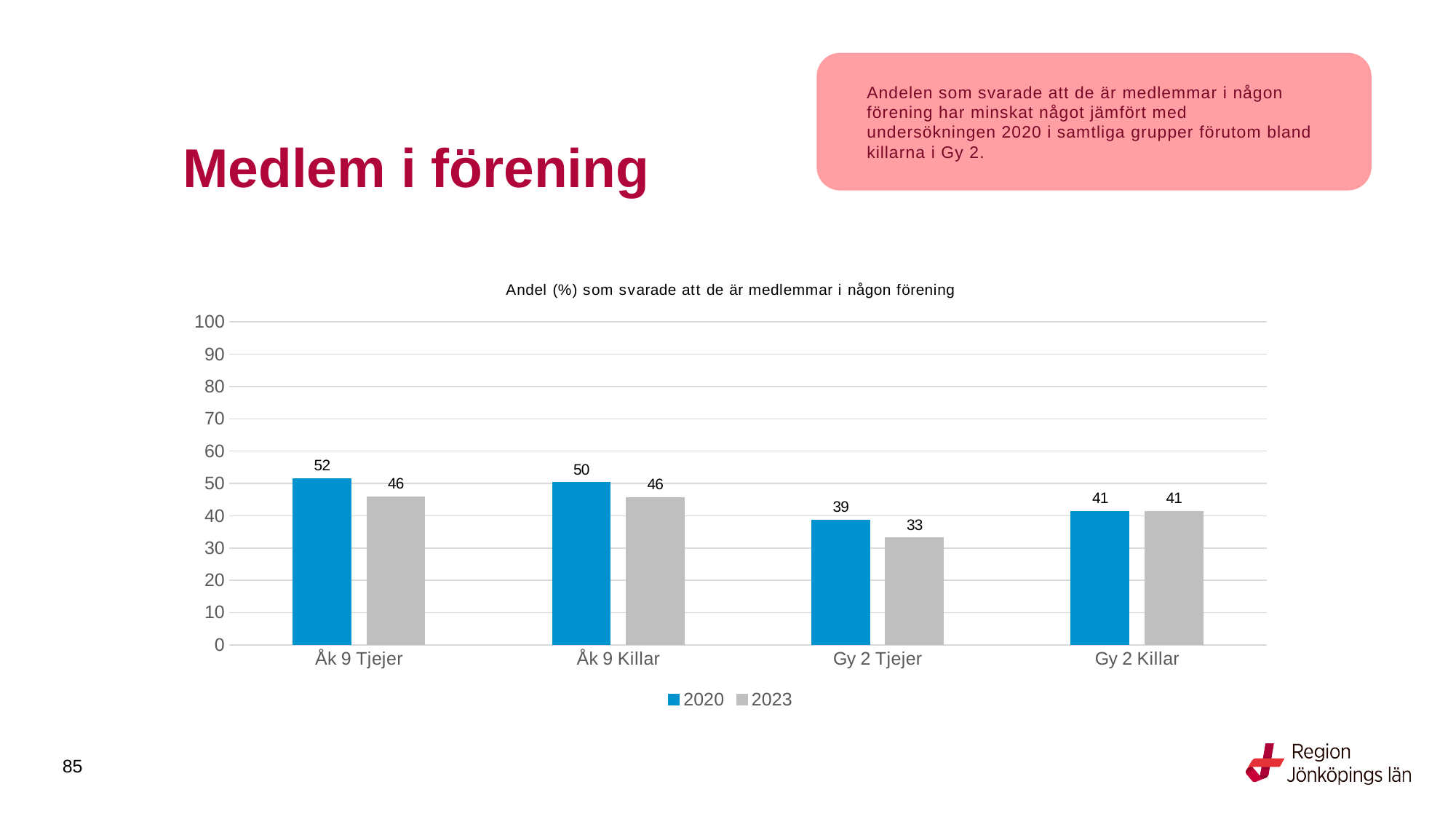
Is the 2020 value for Gy 2 Killar greater or less than 50? less What kind of chart is shown on the slide? Bar chart What is the difference between the 2020 and 2023 values for Gy 2 Tjejer? 6 How many categories are shown on the x axis? 4 What is the value for Gy 2 Tjejer in 2023? 33 How many series does the legend list? 2 What is the value for Gy 2 Killar in 2023? 41 Which category has the lowest value for 2023? Gy 2 Tjejer Which is larger: the 2020 value for Åk 9 Killar or the 2023 value for Åk 9 Killar? 2020 value for Åk 9 Killar Which category has the highest value for 2020? Åk 9 Tjejer What is the value for Åk 9 Tjejer in 2020? 52 What is the title of the chart? Andel (%) som svarade att de är medlemmar i någon förening